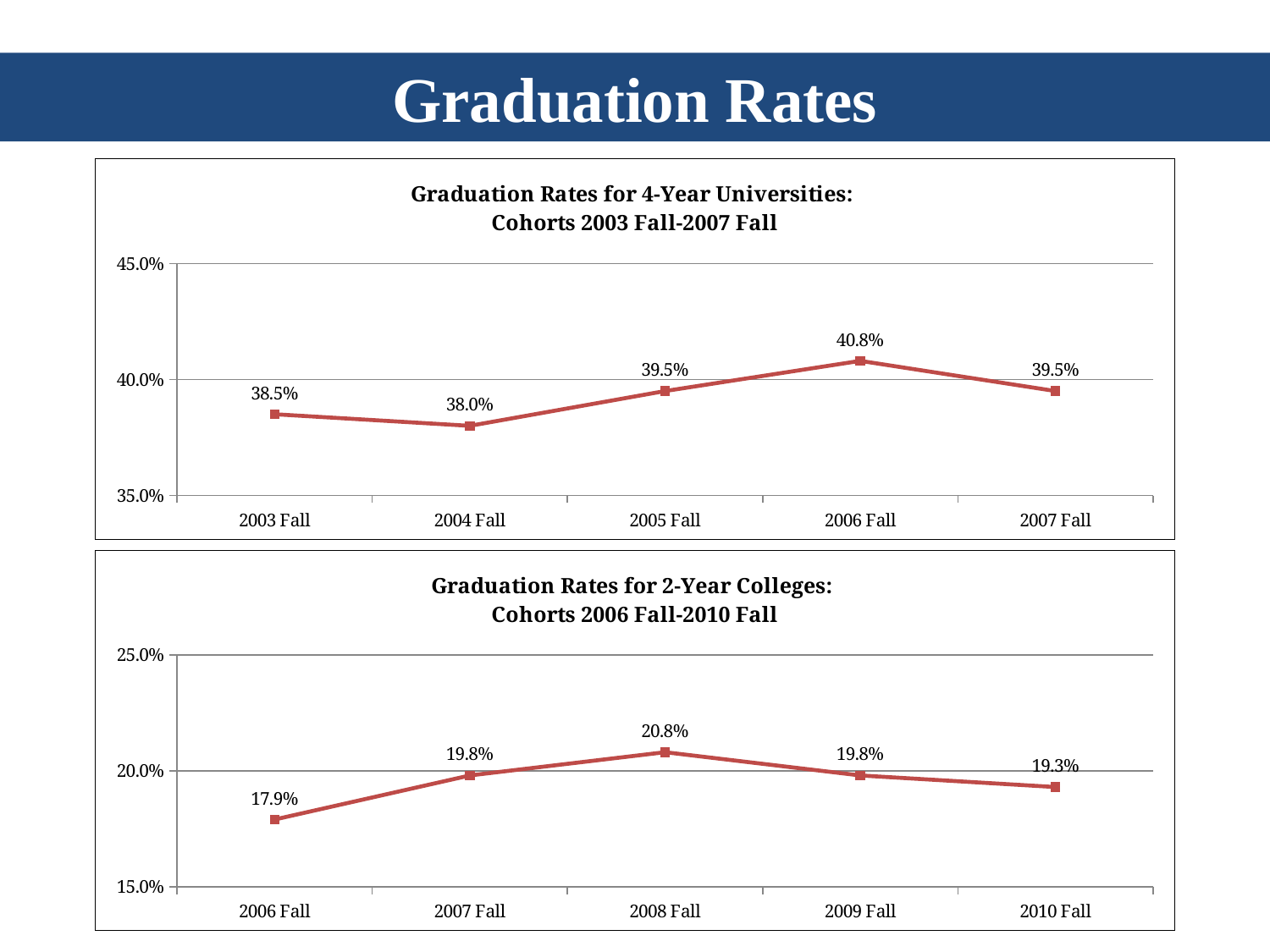
In the 'Graduation Rates for 2-Year Colleges' chart, which is larger, the 2006 Fall value or the 2009 Fall value? 2009 Fall In the 'Graduation Rates for 4-Year Universities' chart, how many cohorts are plotted? 5 In the 'Graduation Rates for 2-Year Colleges' chart, what is the difference between the 2008 Fall and 2006 Fall graduation rates? 2.9% In the 'Graduation Rates for 2-Year Colleges' chart, which cohort has the highest graduation rate? 2008 Fall In the 'Graduation Rates for 4-Year Universities' chart, which cohort has the lowest graduation rate? 2004 Fall What kind of chart is the 'Graduation Rates for 2-Year Colleges' chart? line chart In the 'Graduation Rates for 4-Year Universities' chart, what is the difference between the 2006 Fall and 2004 Fall graduation rates? 2.8% In the 'Graduation Rates for 4-Year Universities' chart, what is the graduation rate for the 2006 Fall cohort? 40.8% What is the title of the top chart on the slide? Graduation Rates for 4-Year Universities: Cohorts 2003 Fall-2007 Fall In the 'Graduation Rates for 4-Year Universities' chart, is the 2003 Fall value greater or less than 40.0%? less In the 'Graduation Rates for 2-Year Colleges' chart, do the values rise or fall from 2008 Fall to 2010 Fall? fall In the 'Graduation Rates for 2-Year Colleges' chart, what is the graduation rate for the 2010 Fall cohort? 19.3%